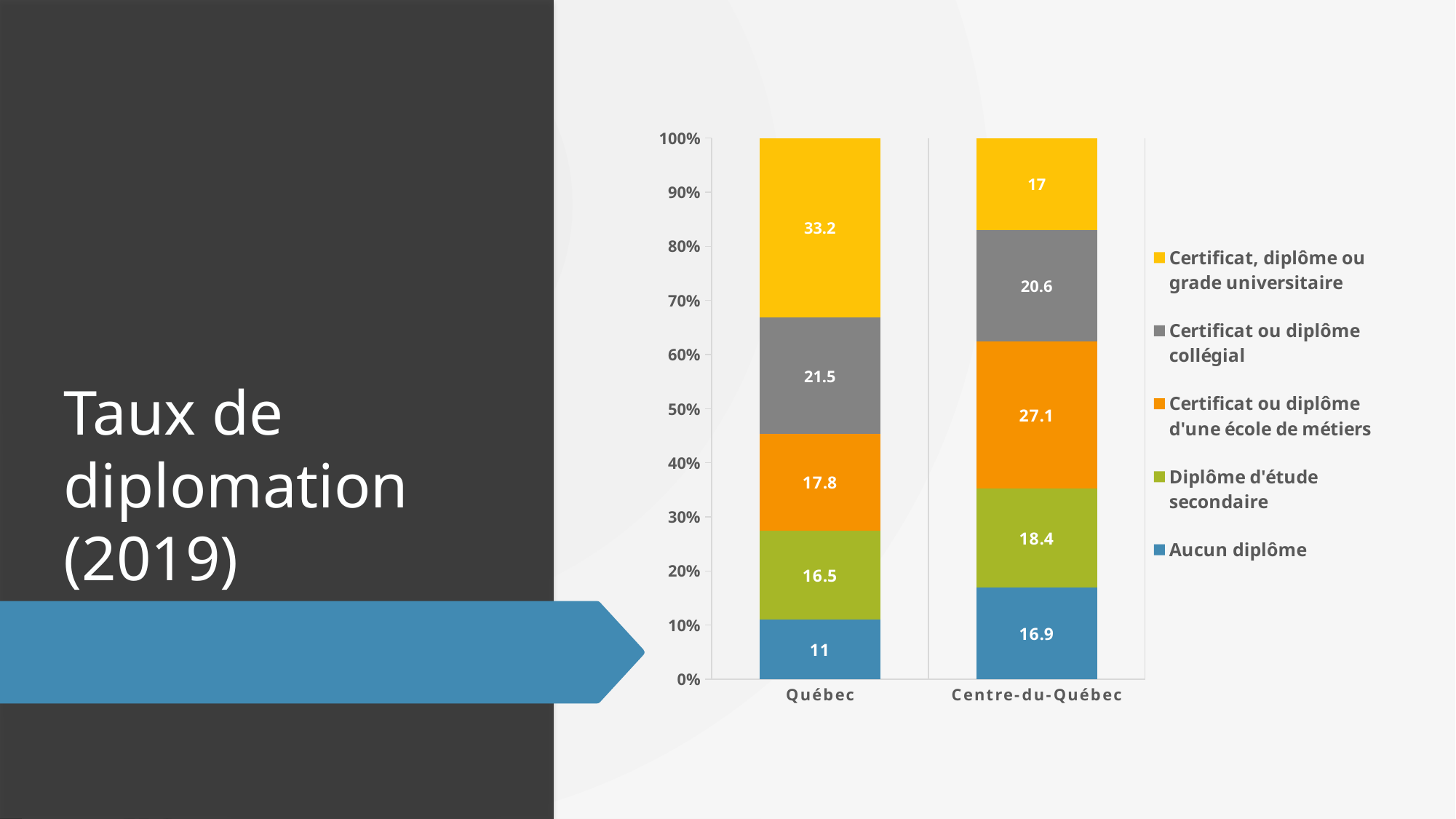
What is the value for "Certificat, diplôme ou grade universitaire" in Québec? 33.2 How many categories are shown on the x axis? 2 What is the title of the slide? Taux de diplomation (2019) What is the value for "Aucun diplôme" in Québec? 11 Which region has the larger value for "Diplôme d'étude secondaire", Québec or Centre-du-Québec? Centre-du-Québec What is the value for "Certificat ou diplôme d'une école de métiers" in Centre-du-Québec? 27.1 Which series has the smallest value in the Centre-du-Québec bar? Aucun diplôme How many series does the legend list? 5 What is the value for "Certificat ou diplôme collégial" in Centre-du-Québec? 20.6 Which series has the largest value in the Québec bar? Certificat, diplôme ou grade universitaire What is the difference between the "Certificat, diplôme ou grade universitaire" values for Québec and Centre-du-Québec? 16.2 What kind of chart is shown on the slide? Stacked bar chart